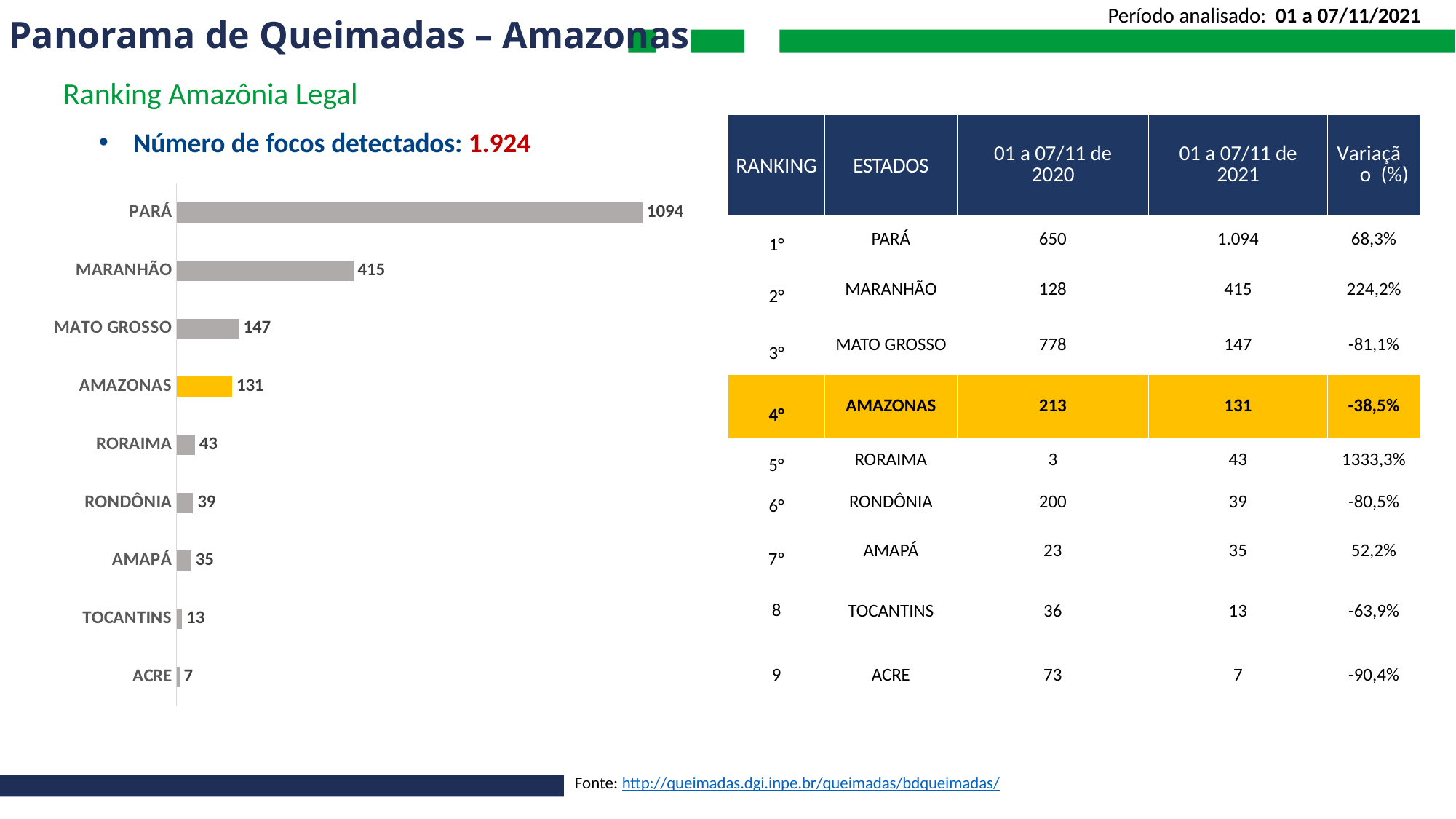
Which state has the lowest value in the bar chart? ACRE What is the total number of focos detectados stated above the bar chart? 1.924 Which state has the highest value in the bar chart? PARÁ How many states are shown in the bar chart? 9 What is the value for RORAIMA in the bar chart? 43 What kind of chart is shown on the slide? bar chart What is the value for PARÁ in the bar chart? 1094 Which bar in the chart is highlighted in yellow rather than grey? AMAZONAS What is the difference between the values for MARANHÃO and MATO GROSSO in the bar chart? 268 What is the value for AMAZONAS in the bar chart? 131 Which is larger in the bar chart, the value for RONDÔNIA or the value for AMAPÁ? RONDÔNIA What is the difference between the values for TOCANTINS and ACRE in the bar chart? 6